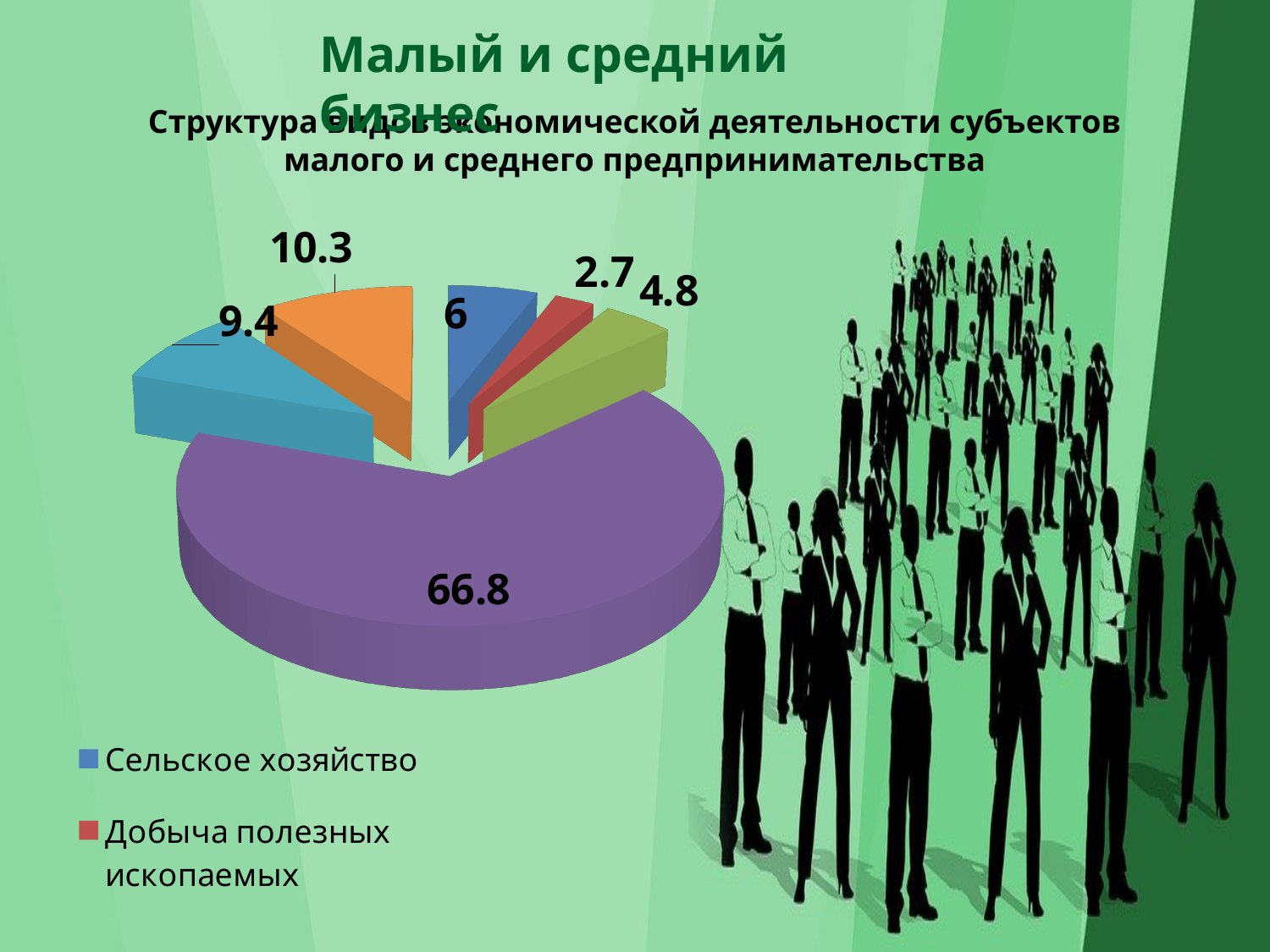
What is the value of the largest slice in the pie chart? 66.8 What is the value for Сельское хозяйство in the pie chart? 6 What type of chart is shown on the slide? pie chart What is the value of the smallest slice in the pie chart? 2.7 What is the title of the pie chart? Структура видов экономической деятельности субъектов малого и среднего предпринимательства What is the value for Добыча полезных ископаемых in the pie chart? 2.7 How many slices does the pie chart have? 6 What is the difference between the value for Сельское хозяйство and the value for Добыча полезных ископаемых? 3.3 What is the difference between the largest slice value and the smallest slice value in the pie chart? 64.1 Which is larger, the value for Сельское хозяйство or the value for Добыча полезных ископаемых? Сельское хозяйство What colour is the slice for Сельское хозяйство in the pie chart? blue Which of the two legend categories, Сельское хозяйство or Добыча полезных ископаемых, has the smaller slice? Добыча полезных ископаемых